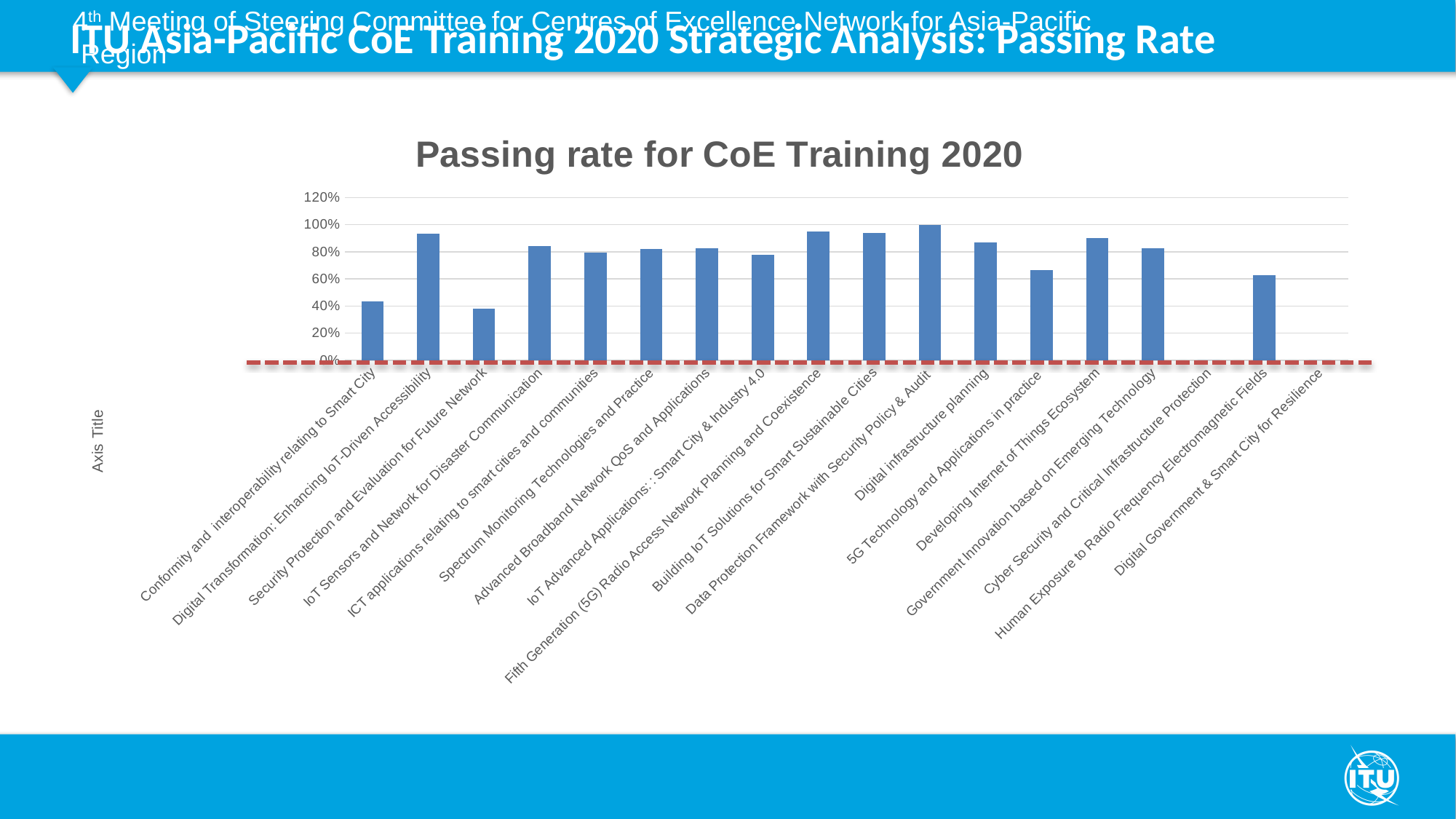
What is the highest tick value shown on the vertical axis of the chart? 120% What type of chart is shown on the slide? Bar chart Is the passing rate for '5G Technology and Applications in practice' greater or less than 80%? less Is the passing rate for 'Digital Transformation: Enhancing IoT-Driven Accessibility' greater or less than 80%? greater Which has the higher passing rate: 'Conformity and interoperability relating to Smart City' or 'IoT Sensors and Network for Disaster Communication'? IoT Sensors and Network for Disaster Communication Which training has the highest passing rate in the chart? Data Protection Framework with Security Policy & Audit Which has the higher passing rate: 'Digital Transformation: Enhancing IoT-Driven Accessibility' or 'Security Protection and Evaluation for Future Network'? Digital Transformation: Enhancing IoT-Driven Accessibility What is the title of the chart? Passing rate for CoE Training 2020 Is the passing rate for 'Conformity and interoperability relating to Smart City' greater or less than 60%? less How many training categories are labelled on the x axis of the chart? 18